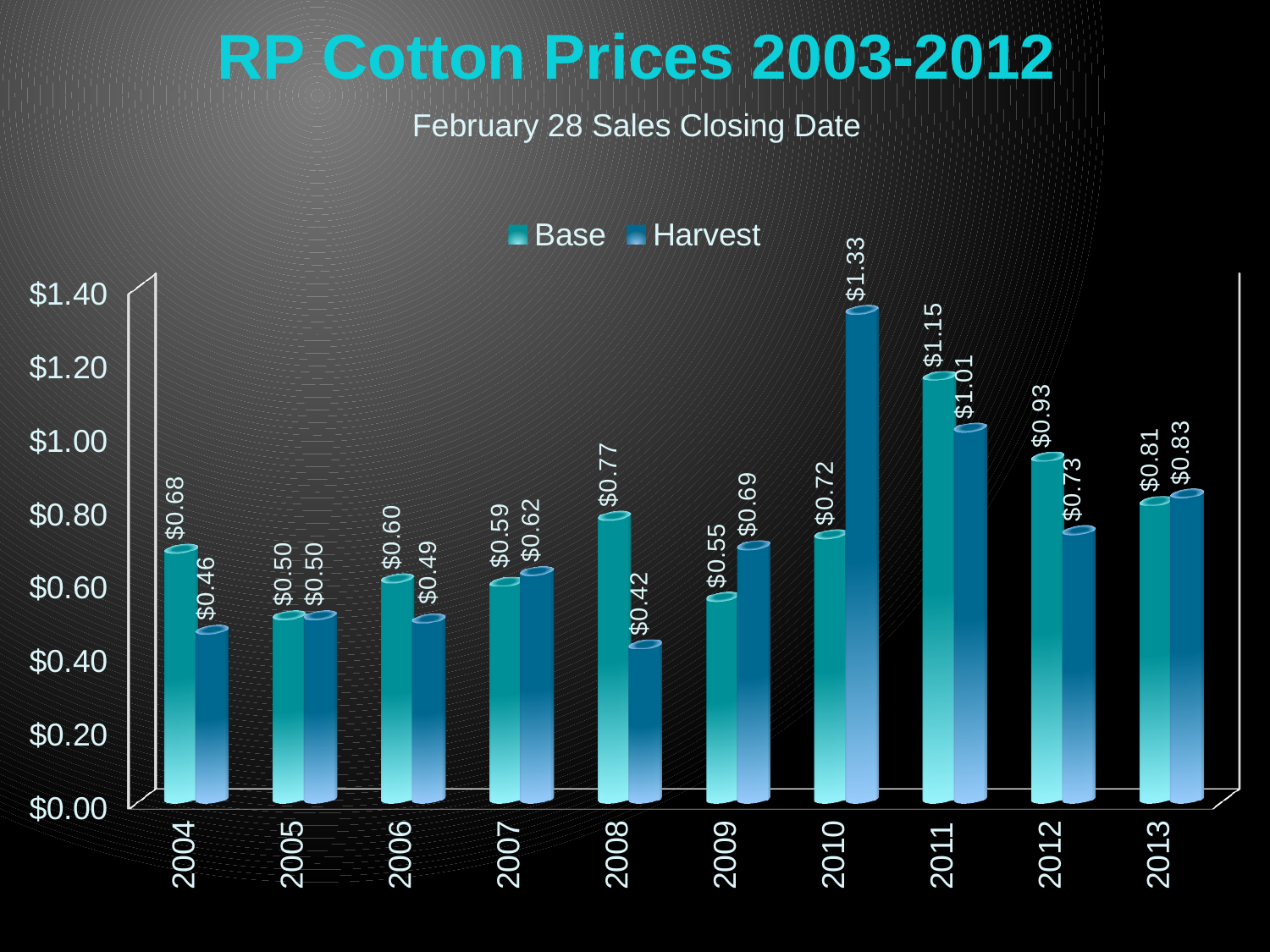
What is the Base value for 2008? $0.77 How many series does the legend list? 2 What are the two series named in the legend? Base and Harvest What is the title of the chart? RP Cotton Prices 2003-2012 What is the Harvest value for 2012? $0.73 How many years are shown on the x axis? 10 What kind of chart is shown on the slide? Bar chart Which year has the lowest Harvest value? 2008 What is the difference between the Harvest and Base values for 2010? $0.61 Which is larger for 2004, the Base value or the Harvest value? Base What is the Harvest value for 2010? $1.33 Which year has the highest Base value? 2011